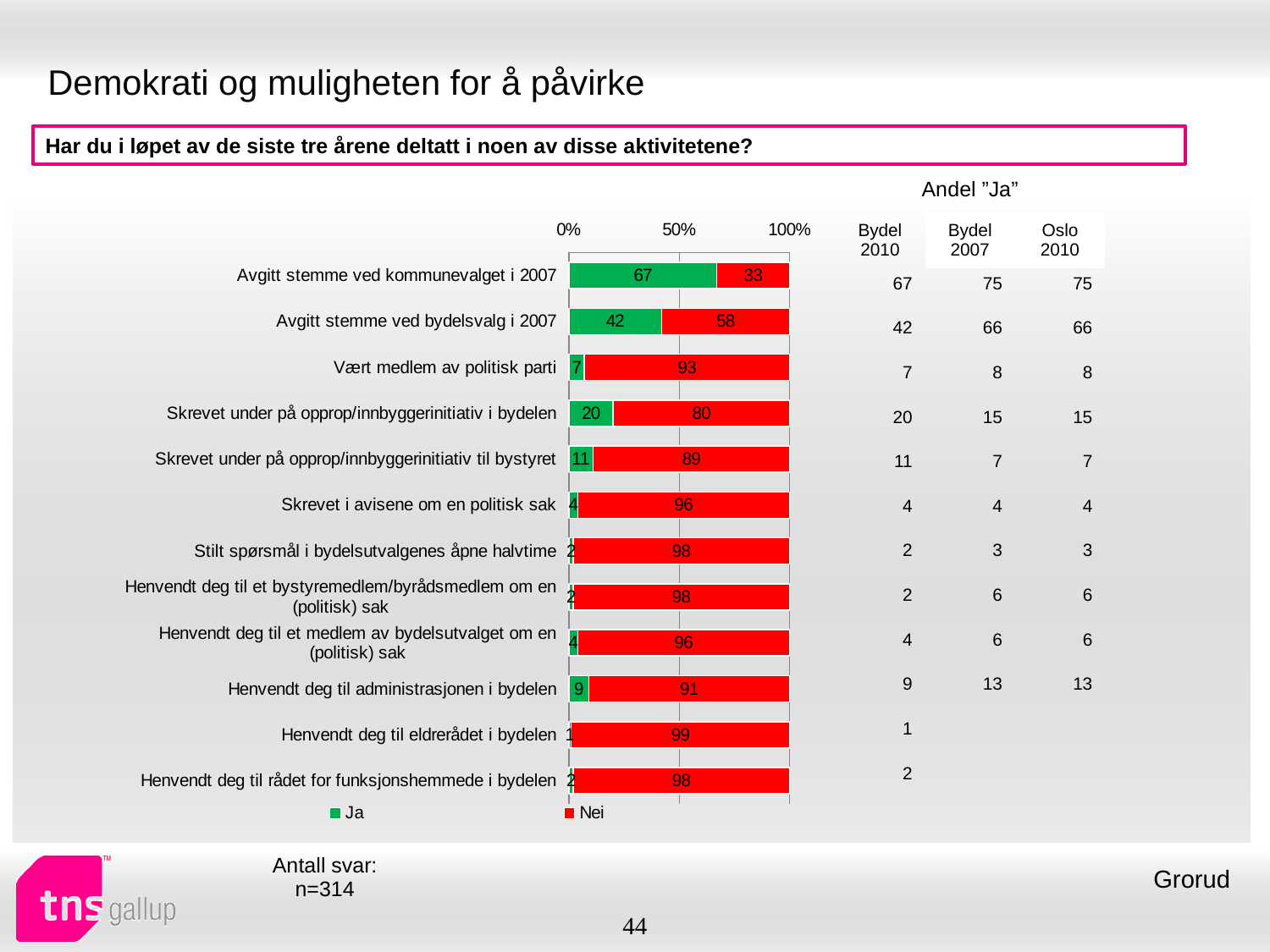
Which activity has the highest "Ja" value? Avgitt stemme ved kommunevalget i 2007 Which has a larger "Ja" value: "Vært medlem av politisk parti" or "Skrevet under på opprop/innbyggerinitiativ til bystyret"? Skrevet under på opprop/innbyggerinitiativ til bystyret What is the "Ja" value for "Skrevet under på opprop/innbyggerinitiativ i bydelen"? 20 How many activities (categories) are shown in the chart? 12 Which colour represents "Nei" in the chart? Red What kind of chart is shown on the slide? Stacked bar chart Which activity has the lowest "Ja" value? Henvendt deg til eldrerådet i bydelen What is the "Nei" value for "Avgitt stemme ved bydelsvalg i 2007"? 58 What is the "Ja" value for "Avgitt stemme ved kommunevalget i 2007"? 67 What is the difference between the "Ja" values for "Avgitt stemme ved kommunevalget i 2007" and "Avgitt stemme ved bydelsvalg i 2007"? 25 What is the "Nei" value for "Henvendt deg til administrasjonen i bydelen"? 91 How many series does the legend list? 2